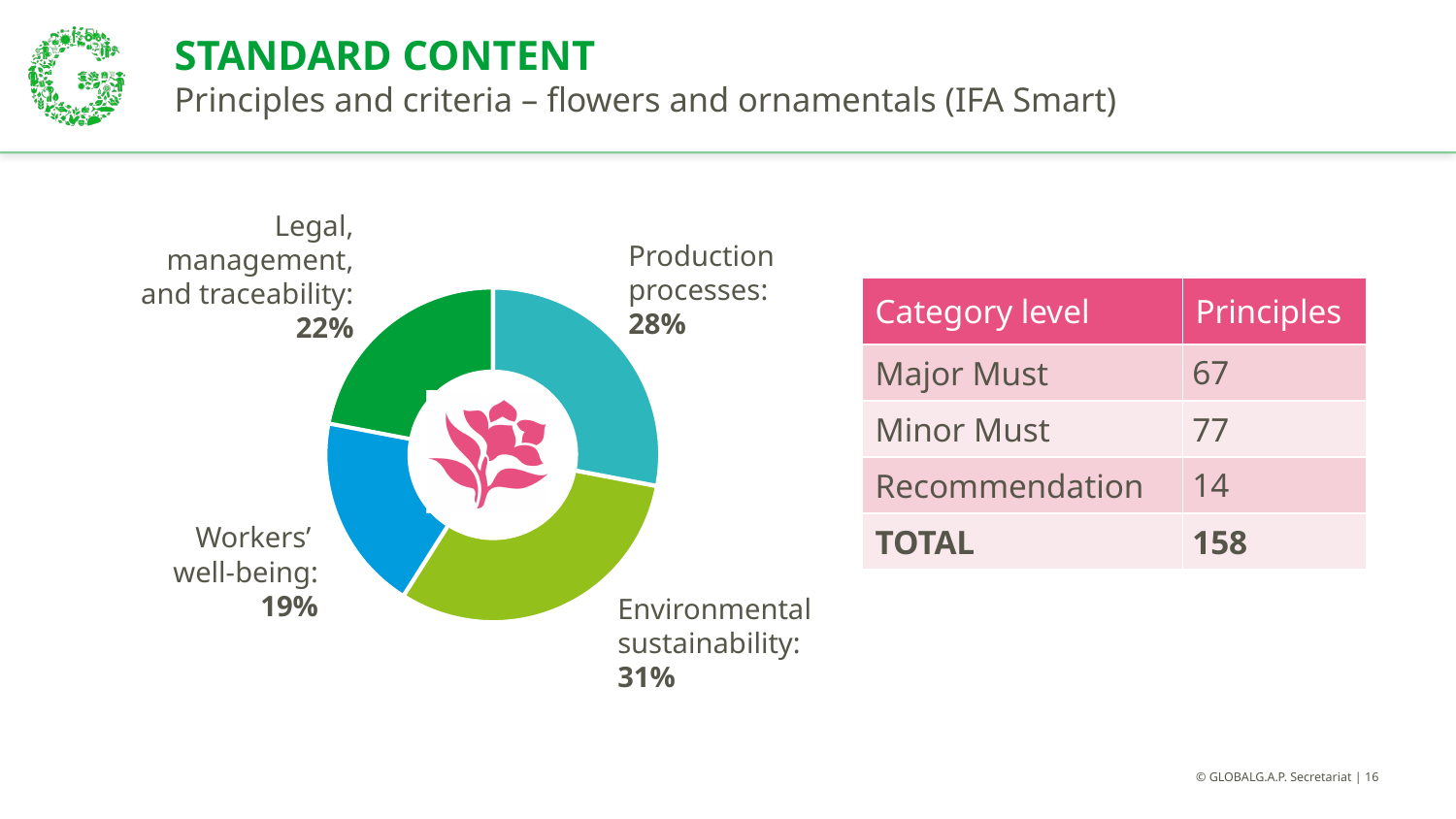
What share of the donut chart is Workers' well-being? 19% What is the difference in percentage points between Production processes and Legal, management, and traceability? 6 Which is larger: the share for Production processes or the share for Legal, management, and traceability? Production processes What is the difference in percentage points between Environmental sustainability and Workers' well-being? 12 What type of chart is shown on the slide? Donut (pie) chart What share of the donut chart is Legal, management, and traceability? 22% Which category has the largest share of the donut chart? Environmental sustainability Which category has the smallest share of the donut chart? Workers' well-being What share of the donut chart is Environmental sustainability? 31% How many categories are shown in the donut chart? 4 What share of the donut chart is Production processes? 28% What colour is the Workers' well-being slice of the donut chart? Blue